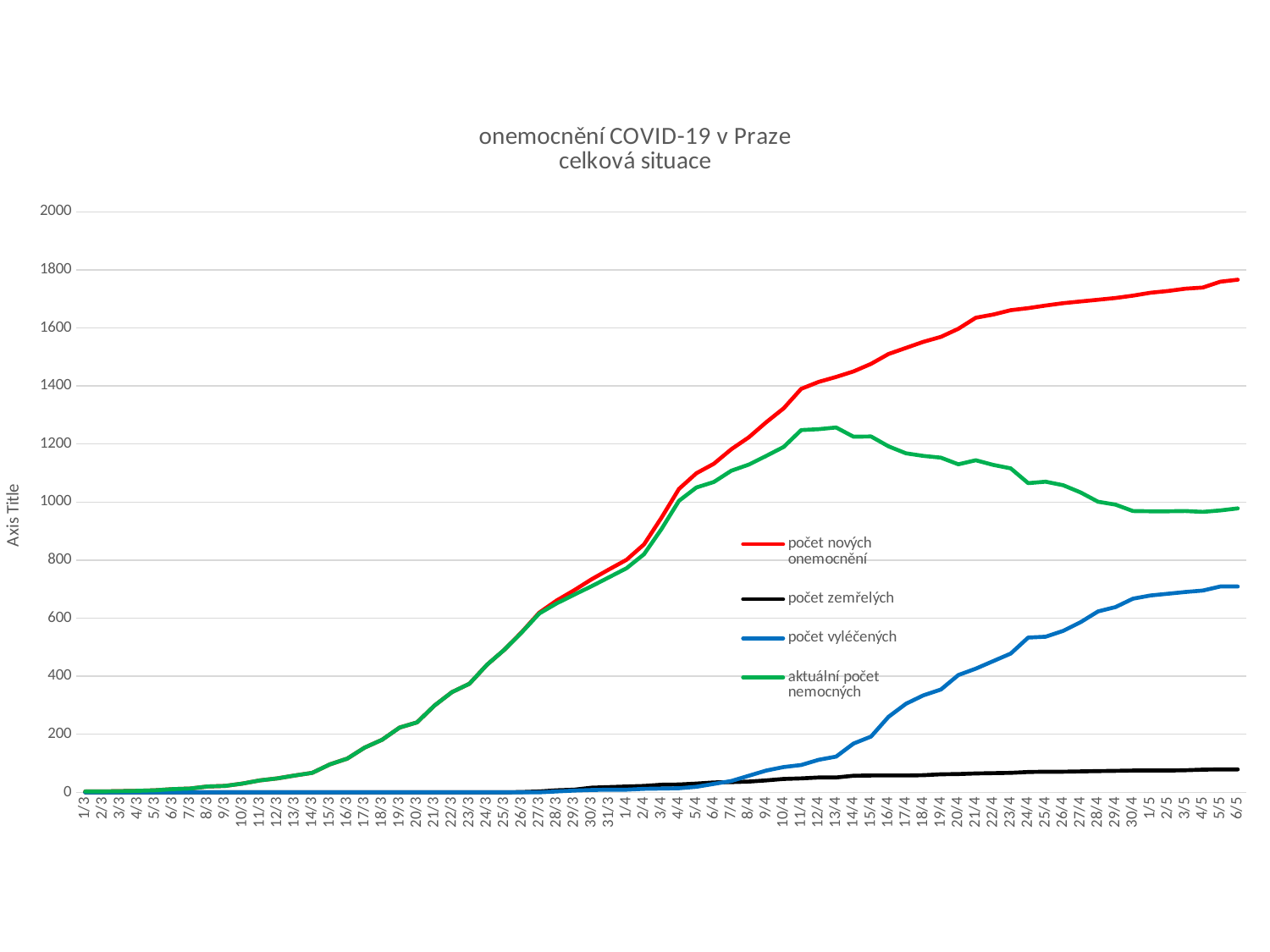
How many series does the legend list? 4 Which series has the highest value on 6/5? počet nových onemocnění What kind of chart is shown on the slide? line chart Is the value for počet vyléčených on 6/5 greater or less than 800? less Is the value for počet zemřelých on 6/5 greater or less than 200? less What is the label on the vertical axis? Axis Title Which series has the lowest value on 6/5? počet zemřelých On 6/5, which is larger: počet vyléčených or aktuální počet nemocných? aktuální počet nemocných What is the title of the chart? onemocnění COVID-19 v Praze celková situace Is the value for aktuální počet nemocných on 6/5 greater or less than 800? greater Does the počet nových onemocnění series rise or fall from 1/3 to 6/5? rise